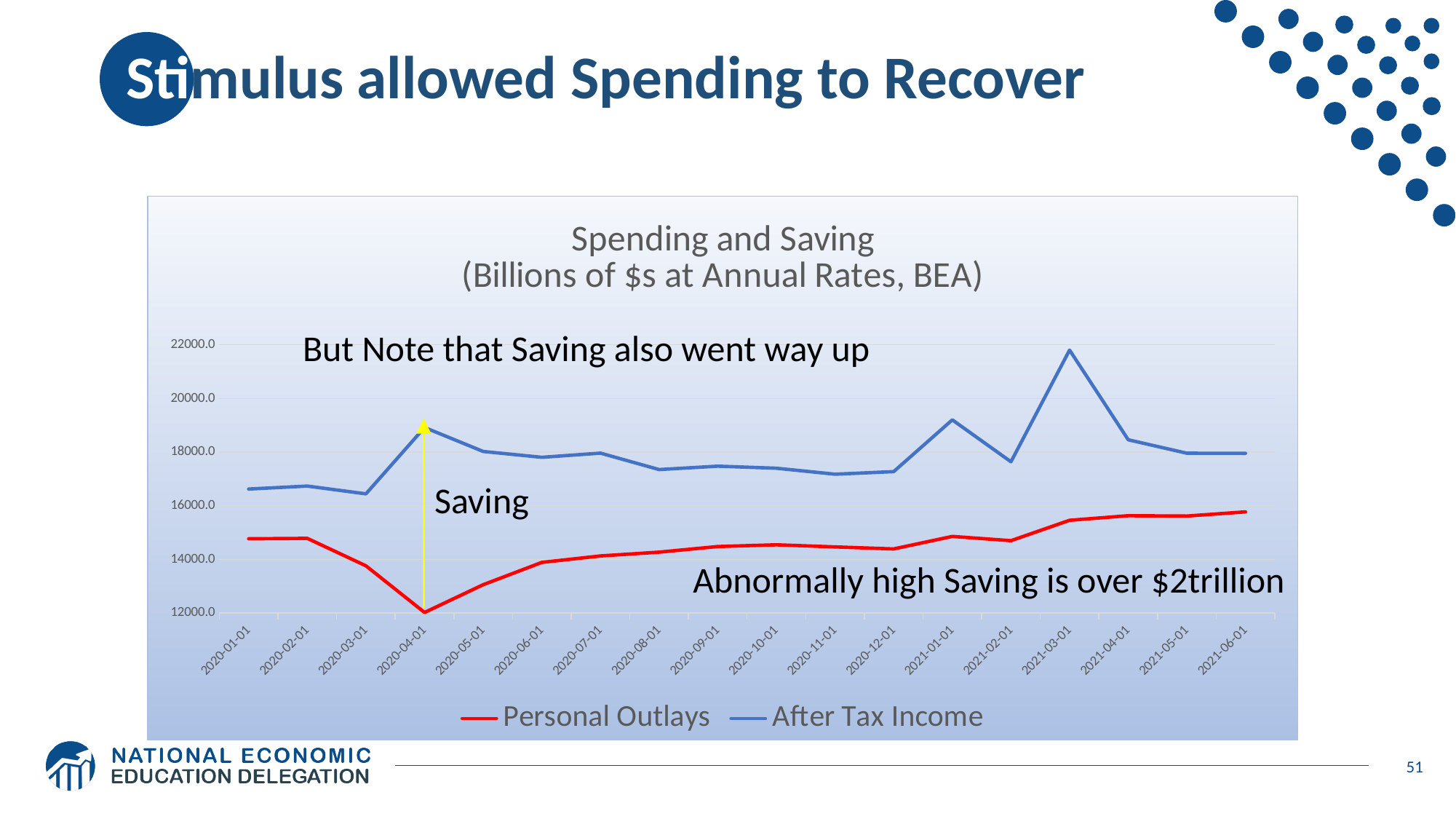
What is the title of the chart? Spending and Saving (Billions of $s at Annual Rates, BEA) How many series does the legend list? 2 Is the value for Personal Outlays on 2020-01-01 greater or less than 16000.0? less On which date does After Tax Income reach its highest value? 2021-03-01 What kind of chart is shown on the slide? line chart On which date does Personal Outlays reach its lowest value? 2020-04-01 How many dates are plotted along the x axis? 18 On 2020-04-01, which series has the higher value, Personal Outlays or After Tax Income? After Tax Income Is the value for After Tax Income on 2020-01-01 greater or less than 16000.0? greater Do Personal Outlays rise or fall from 2020-04-01 to 2021-06-01? rise What colour is the After Tax Income line? blue Is the value for After Tax Income on 2021-03-01 greater or less than 20000.0? greater